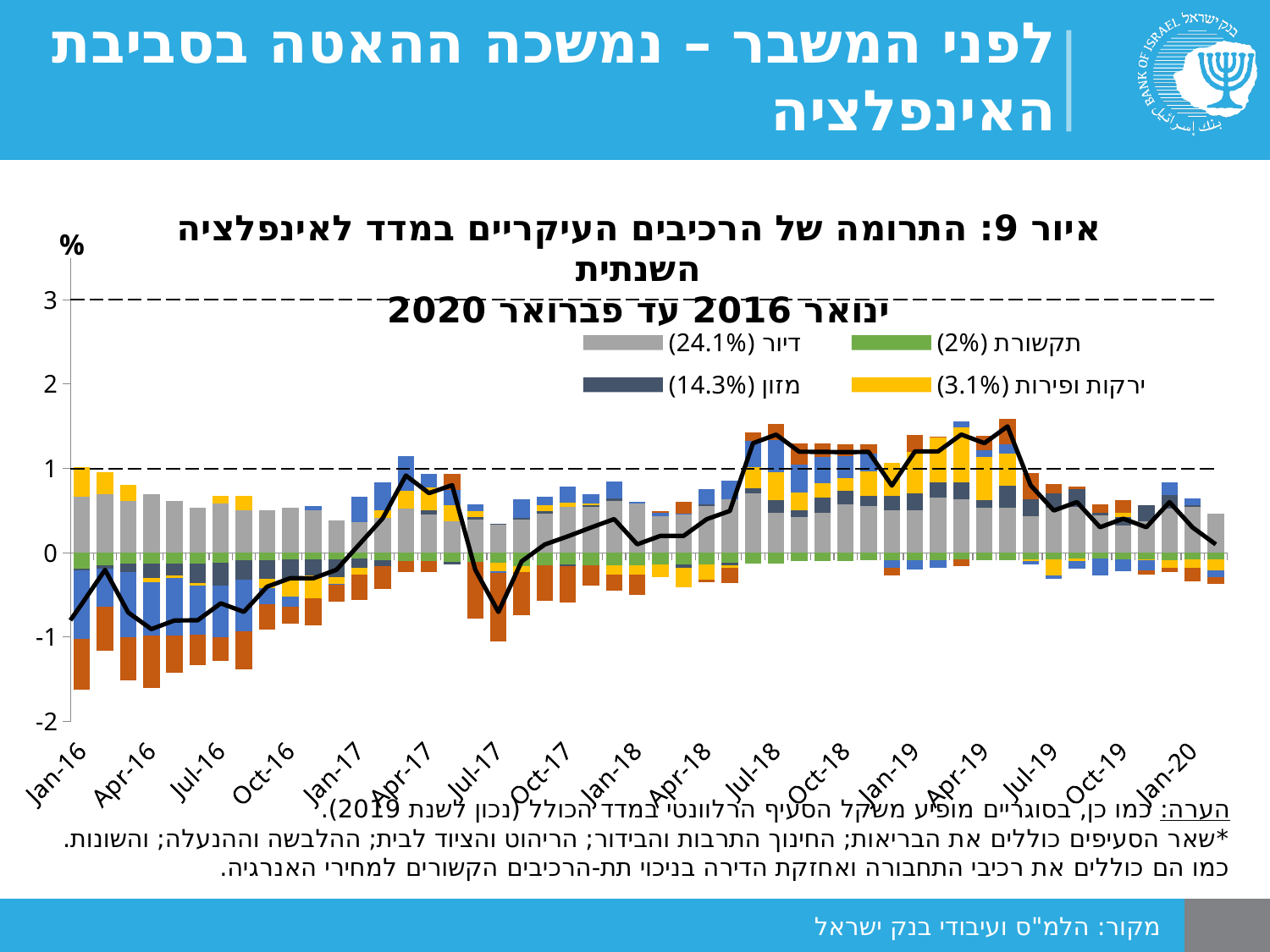
What kind of chart is shown on the slide? Stacked bar chart with a line overlay Does the black line rise or fall between Jul-19 and Jan-20? fall Is the value of the black line at Jan-16 greater or less than 0? less Is the value of the black line at Jul-17 greater or less than 0? less Which is larger, the black line value at Jul-18 or at Jan-16? Jul-18 Does the black line rise or fall between Jan-17 and Apr-17? rise How many series are listed in the visible legend? 4 Is the value of the black line at Jan-20 greater or less than 1? less What is the title of the chart? איור 9: התרומה של הרכיבים העיקריים במדד לאינפלציה השנתית ינואר 2016 עד פברואר 2020 According to the legend, what weight is shown for דיור? 24.1%